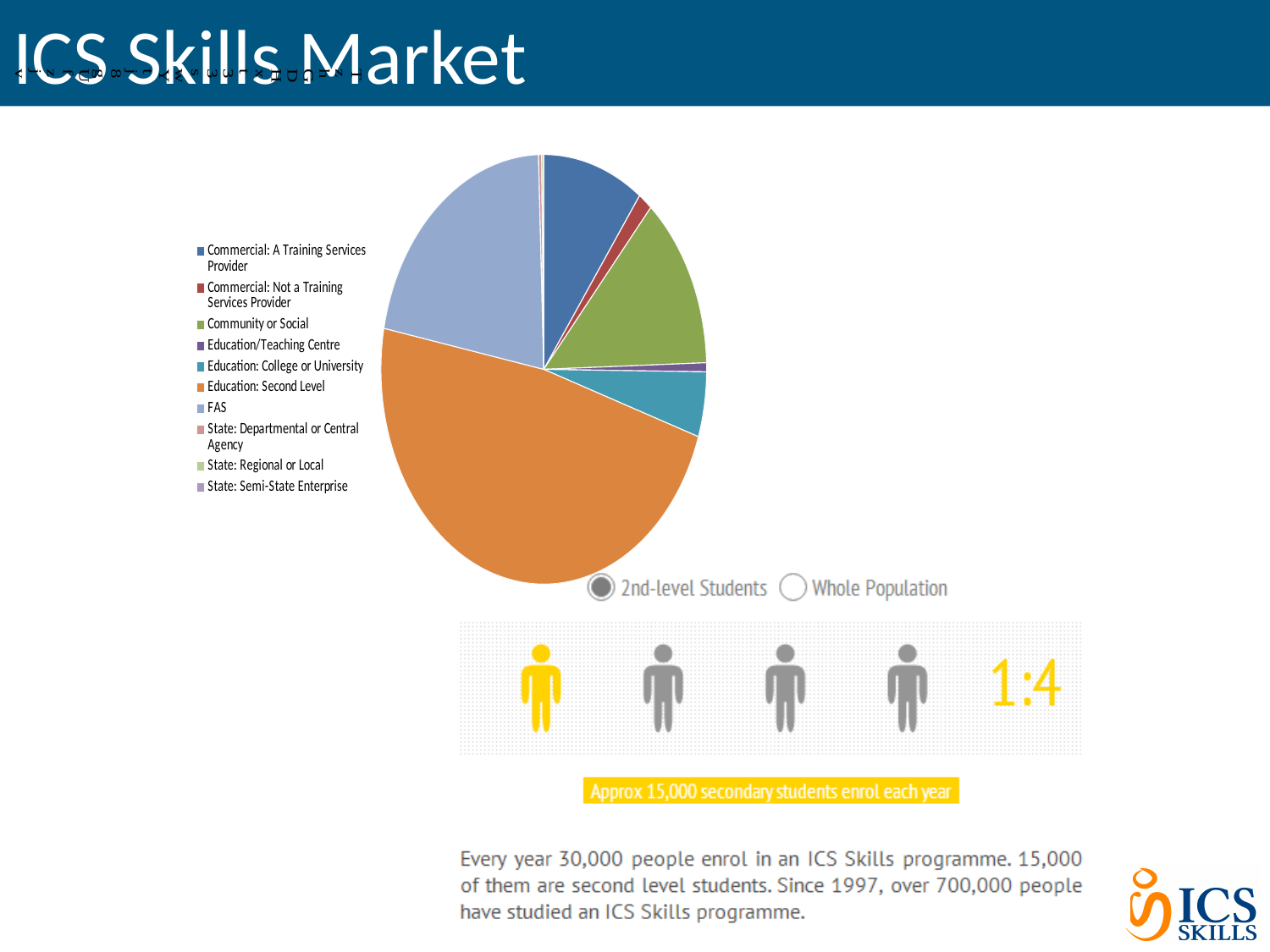
Which slice is larger in the pie chart: FAS or Education: College or University? FAS Which slice is larger in the pie chart: Community or Social or Education: College or University? Community or Social Which category has the largest slice of the pie chart? Education: Second Level How many categories does the pie chart's legend list? 10 What colour is the Education: Second Level slice in the pie chart? orange What kind of chart is shown on the slide? pie chart Which slice is larger in the pie chart: Commercial: A Training Services Provider or Commercial: Not a Training Services Provider? Commercial: A Training Services Provider What is the title of the slide containing the pie chart? ICS Skills Market